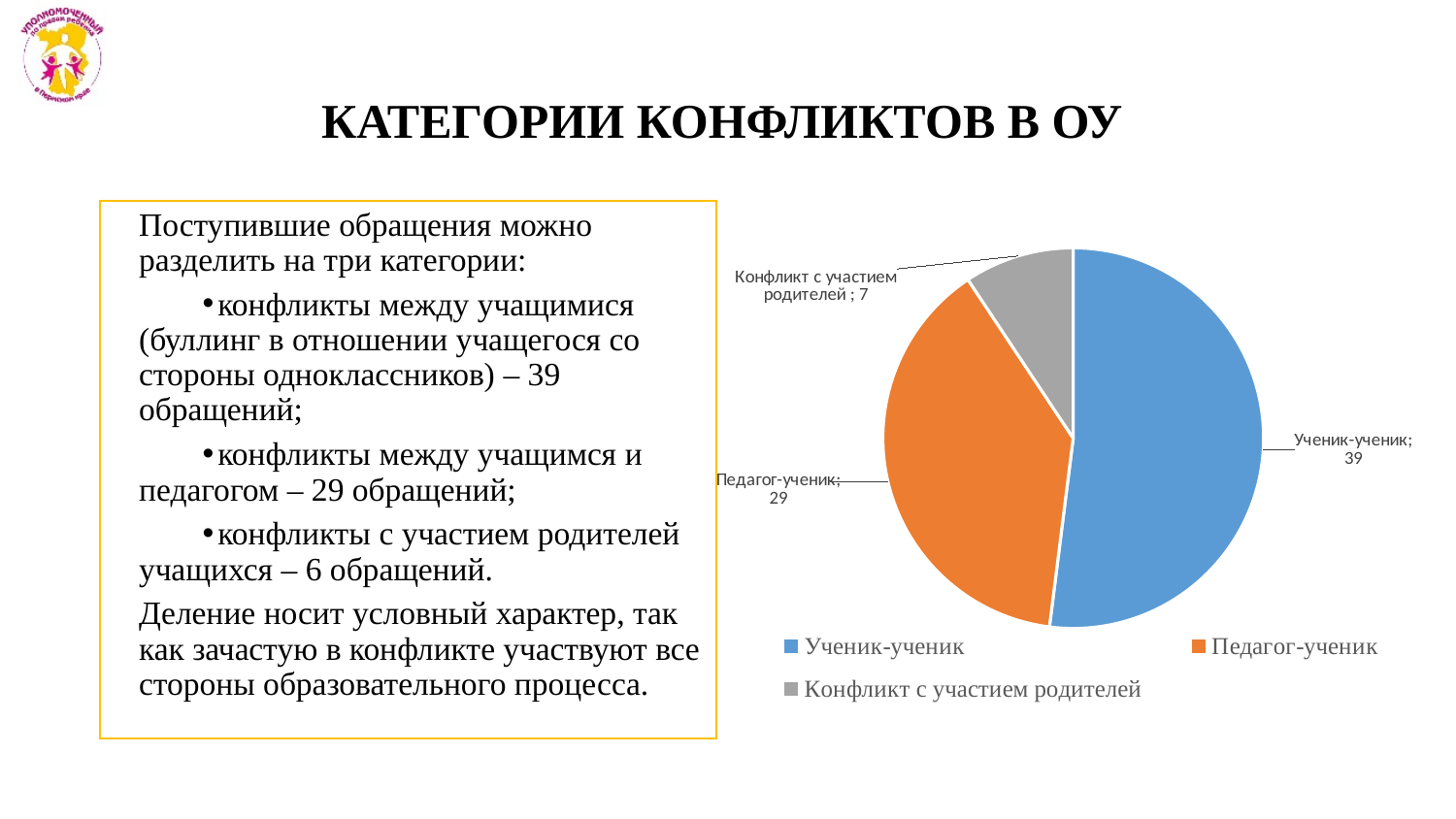
What colour is the Педагог-ученик slice in the pie chart? Orange What is the difference between the Педагог-ученик and Конфликт с участием родителей values in the pie chart? 22 How many slices does the pie chart have? 3 What type of chart is shown on the slide? Pie chart What value does the pie chart show for the Конфликт с участием родителей slice? 7 What share of the pie does the Ученик-ученик slice represent? 52% What value does the pie chart show for the Ученик-ученик slice? 39 Which category has the largest slice in the pie chart? Ученик-ученик Which is larger in the pie chart: Педагог-ученик or Конфликт с участием родителей? Педагог-ученик Which category has the smallest slice in the pie chart? Конфликт с участием родителей What is the difference between the Ученик-ученик and Педагог-ученик values in the pie chart? 10 What value does the pie chart show for the Педагог-ученик slice? 29